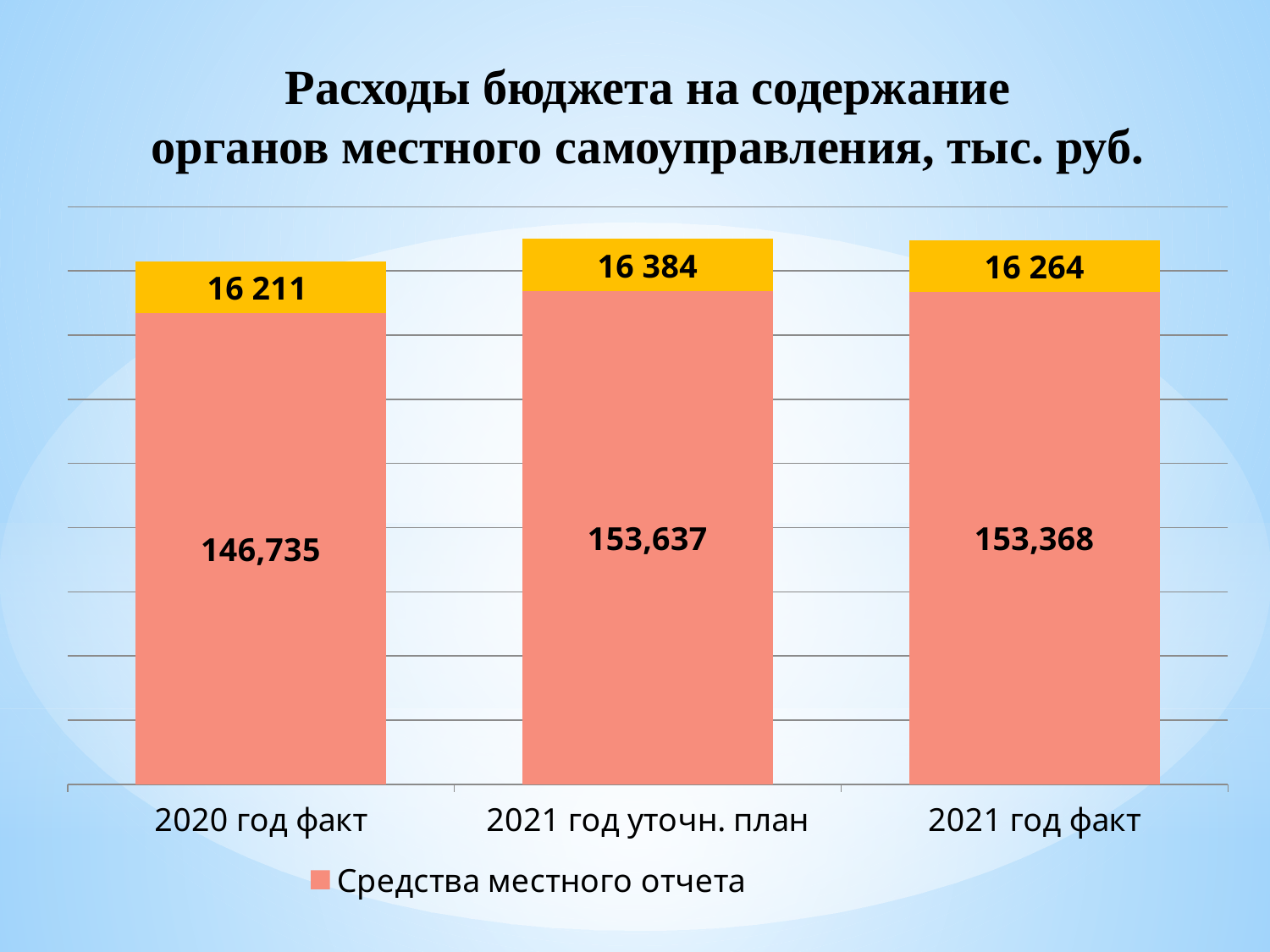
Which is larger, the Средства местного отчета value for 2021 год уточн. план or for 2021 год факт? 2021 год уточн. план How many categories are shown on the x axis? 3 What kind of chart is shown on the slide? Stacked bar chart How many series does the legend list? 1 What is the value of the Средства местного отчета segment for 2021 год уточн. план? 153,637 Which category has the lowest value for the yellow top segment? 2020 год факт What is the legend entry shown below the chart? Средства местного отчета What is the difference between the yellow top segment values for 2021 год уточн. план and 2020 год факт? 173 What is the value of the yellow top segment for 2021 год факт? 16 264 Which category has the highest value for the Средства местного отчета segment? 2021 год уточн. план What is the value of the Средства местного отчета segment for 2021 год факт? 153,368 What is the value of the Средства местного отчета segment for 2020 год факт? 146,735